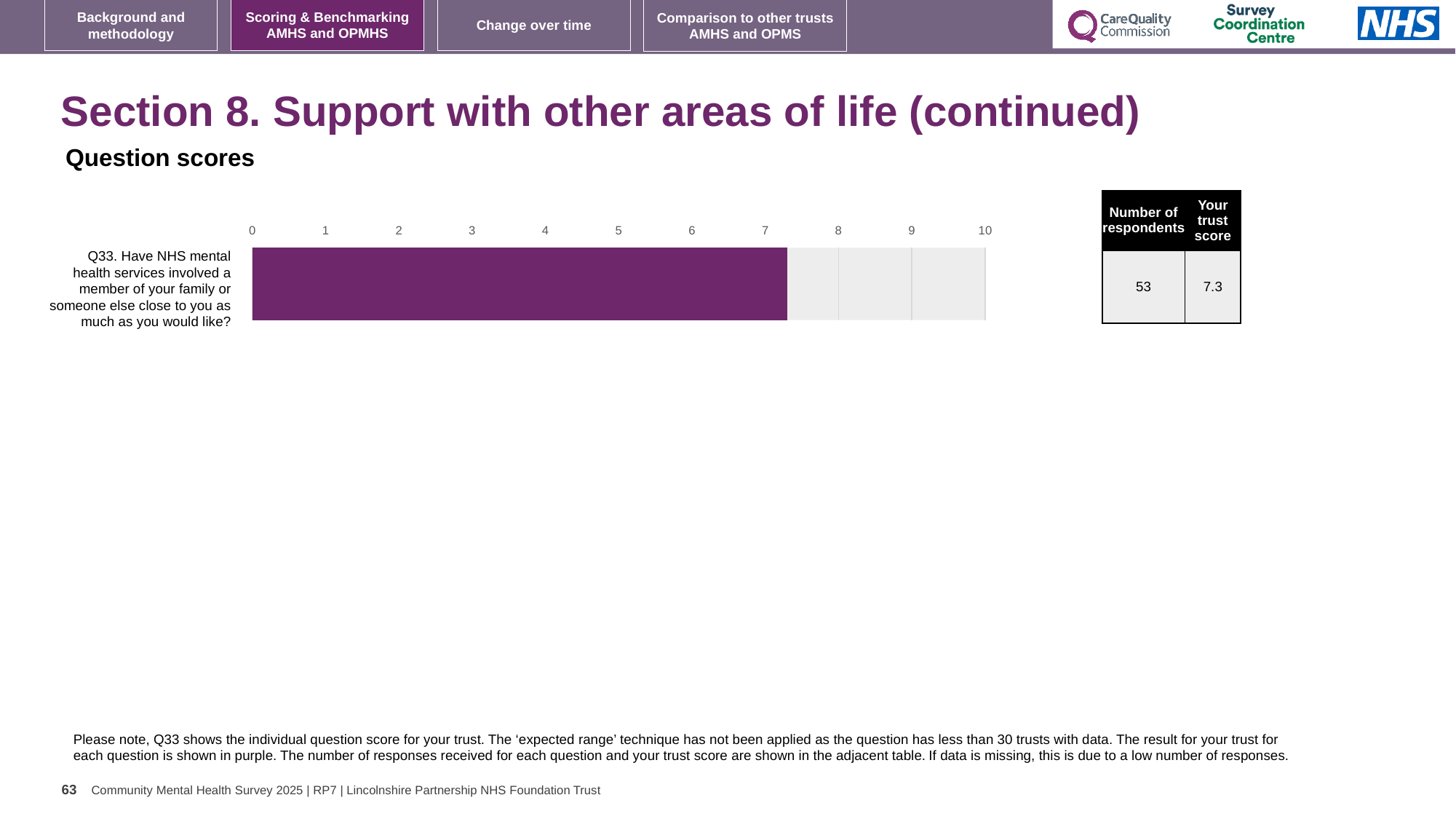
What is the trust score for Q33 shown in the adjacent table? 7.3 What is the maximum value shown on the chart's horizontal axis? 10 Is the value of the bar for Q33 greater or less than 8? less What colour is the bar for Q33? purple Is the value of the bar for Q33 greater or less than 5? greater What is the number of respondents for Q33 shown in the table next to the chart? 53 Is the value of the bar for Q33 greater or less than 7? greater What kind of chart is shown on the slide? bar chart How many questions (bars) are plotted in the chart? 1